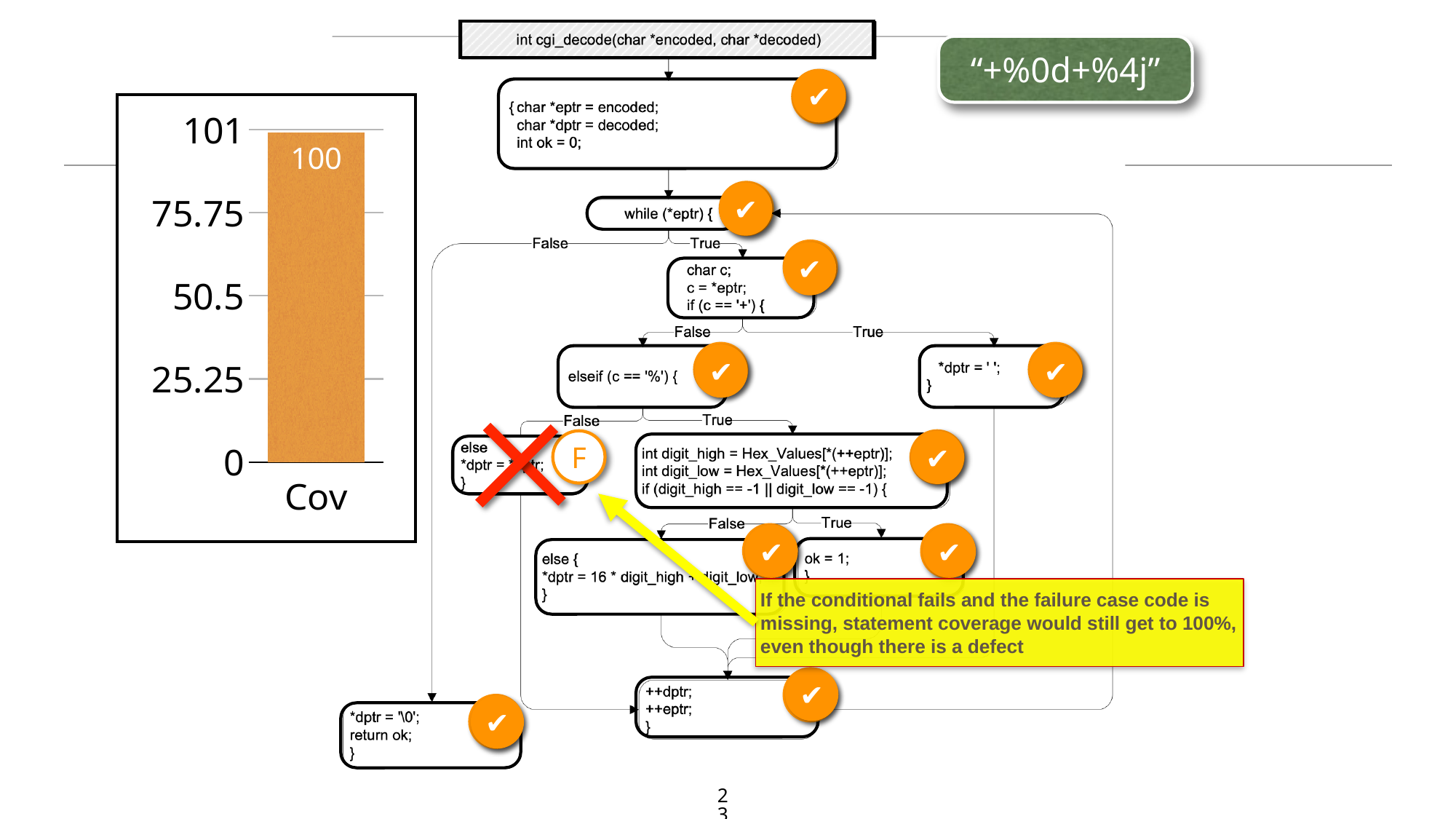
Is the value for Cov greater or less than 50.5? greater What is the label of the category on the x axis of the chart? Cov What kind of chart is shown on the left of the slide? bar chart What is the value of the Cov bar in the bar chart? 100 What is the highest tick value shown on the chart's vertical axis? 101 What is the lowest tick value shown on the chart's vertical axis? 0 Is the value for Cov greater or less than 75.75? greater How many bars does the chart show? 1